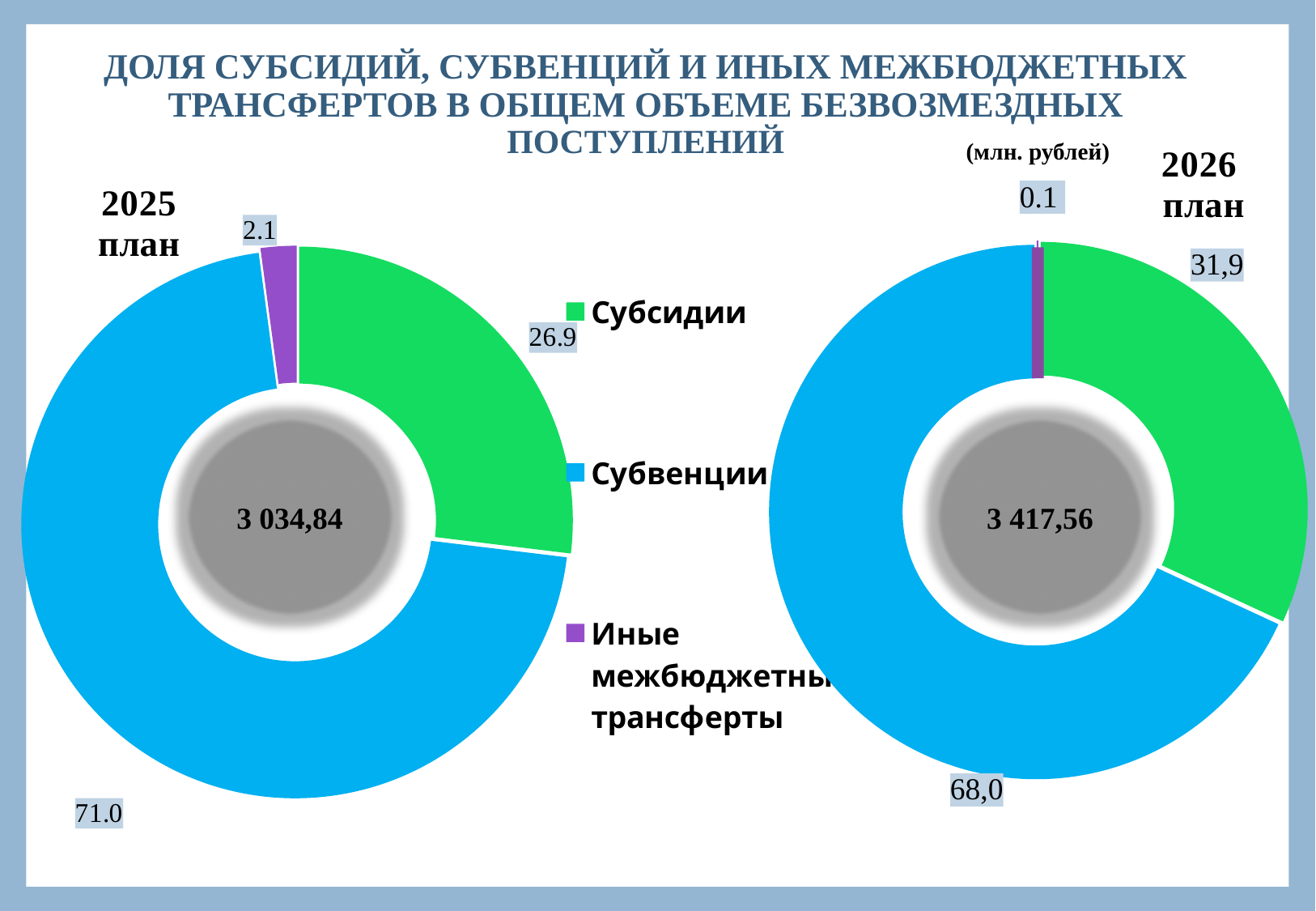
In the 2025 план chart, what is the value shown for Субсидии? 26.9 In the 2025 план chart, what is the value shown for Иные межбюджетные трансферты? 2.1 In the 2026 план chart, which category has the smallest share? Иные межбюджетные трансферты In the 2025 план chart, what is the value shown for Субвенции? 71.0 What total value is shown in the centre of the 2025 план chart? 3 034,84 In the 2026 план chart, what is the value shown for Субвенции? 68,0 In the 2026 план chart, what is the value shown for Иные межбюджетные трансферты? 0.1 In the 2025 план chart, which category has the largest share? Субвенции In the 2026 план chart, what is the value shown for Субсидии? 31,9 What total value is shown in the centre of the 2026 план chart? 3 417,56 How many categories does the legend list? 3 In the 2026 план chart, which is larger: Субсидии or Субвенции? Субвенции